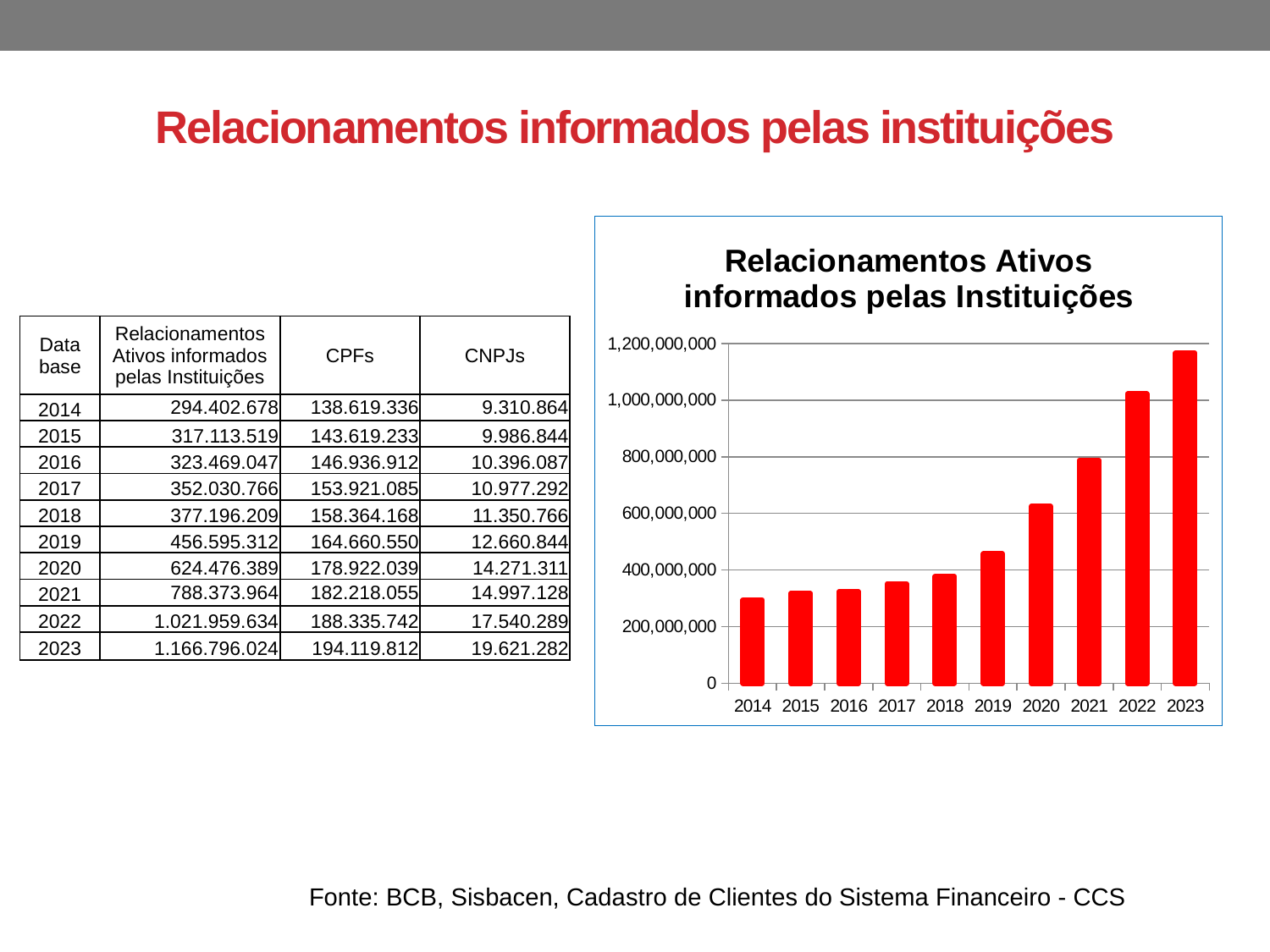
Which year has the lowest bar in the chart? 2014 What is the title of the chart on the slide? Relacionamentos Ativos informados pelas Instituições Which year has the highest bar in the chart? 2023 According to the table on the slide, what is the value of Relacionamentos Ativos informados pelas Instituições for 2023? 1.166.796.024 Is the value for 2014 in the chart greater or less than 400,000,000? less Is the value for 2019 in the chart greater or less than 400,000,000? greater Do the values in the chart rise or fall from 2014 to 2023? rise What kind of chart is shown on the slide? bar chart How many years (bars) are plotted in the chart? 10 Is the value for 2023 in the chart greater or less than 1,000,000,000? greater Which is larger in the chart, the value for 2020 or the value for 2019? 2020 Using the table values on the slide, what is the difference between the Relacionamentos Ativos for 2023 and for 2014? 872.393.346